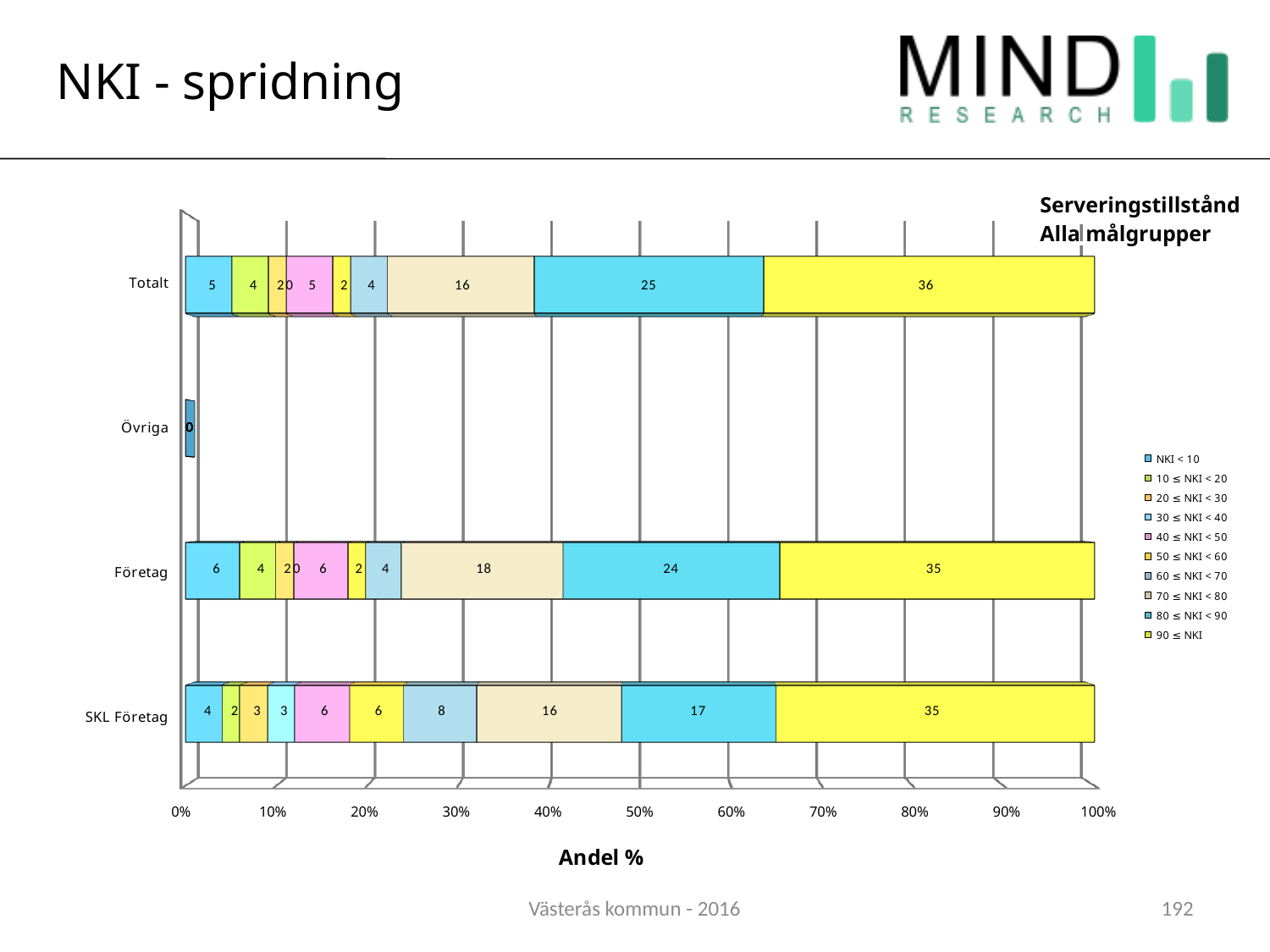
What value is labelled on the bar for Övriga? 0 How many categories are shown on the vertical axis? 4 What is the value of the 80 ≤ NKI < 90 segment for Företag? 24 Which category has the largest 80 ≤ NKI < 90 segment? Totalt What is the value of the 70 ≤ NKI < 80 segment for SKL Företag? 16 What kind of chart is shown on the slide? Stacked bar chart How many series does the legend list? 10 What is the title of the horizontal axis? Andel % What is the difference between the 80 ≤ NKI < 90 segment for Företag and for SKL Företag? 7 What is the difference between the 90 ≤ NKI segment for Totalt and for SKL Företag? 1 What is the value of the 90 ≤ NKI segment for Totalt? 36 Which is larger, the 70 ≤ NKI < 80 segment for Företag or for Totalt? Företag